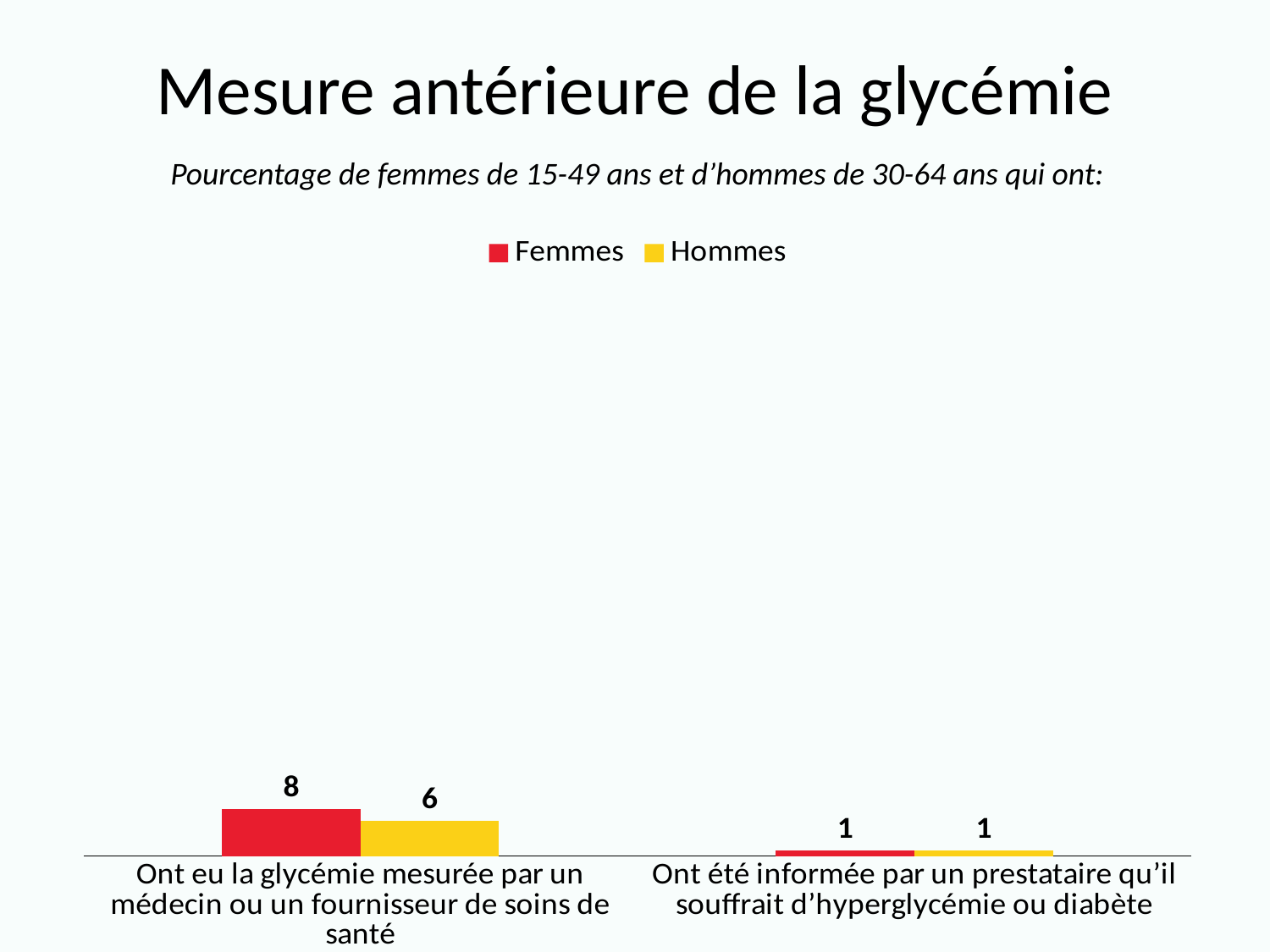
What kind of chart is shown on the slide? Bar chart Which colour represents the Hommes series? Yellow How many categories are shown on the x axis? 2 What is the value for Hommes in the category 'Ont eu la glycémie mesurée par un médecin ou un fournisseur de soins de santé'? 6 What is the value for Femmes in the category 'Ont été informée par un prestataire qu'il souffrait d'hyperglycémie ou diabète'? 1 What is the value for Hommes in the category 'Ont été informée par un prestataire qu'il souffrait d'hyperglycémie ou diabète'? 1 Which series has the highest value in the category 'Ont eu la glycémie mesurée par un médecin ou un fournisseur de soins de santé'? Femmes What is the title of the slide? Mesure antérieure de la glycémie Which is larger: the Femmes value for 'Ont eu la glycémie mesurée par un médecin ou un fournisseur de soins de santé' or the Femmes value for 'Ont été informée par un prestataire qu'il souffrait d'hyperglycémie ou diabète'? Ont eu la glycémie mesurée par un médecin ou un fournisseur de soins de santé What is the value for Femmes in the category 'Ont eu la glycémie mesurée par un médecin ou un fournisseur de soins de santé'? 8 How many series does the legend list? 2 What is the difference between the Femmes and Hommes values for 'Ont eu la glycémie mesurée par un médecin ou un fournisseur de soins de santé'? 2